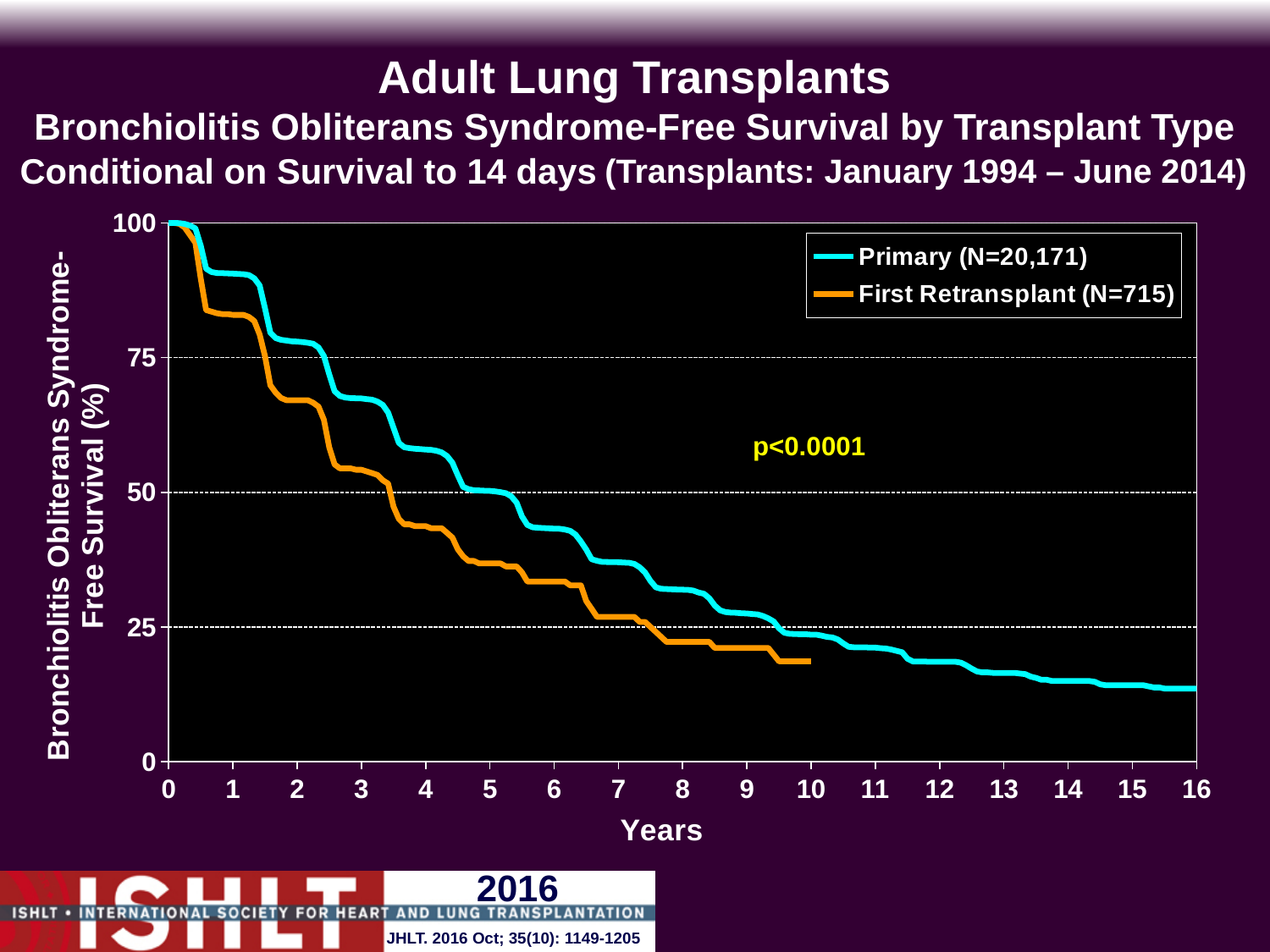
What p-value is printed on the chart? p<0.0001 What is the number of patients (N) in the First Retransplant group shown in the legend? 715 Is the BOS-free survival for the Primary group at 3 years greater or less than 50? greater How many series does the legend list? 2 Do the survival curves rise or fall as years increase along the x axis? fall What is the label of the x axis? Years Is the BOS-free survival for the Primary group at 16 years greater or less than 25? less Is the BOS-free survival for the First Retransplant group at 5 years greater or less than 50? less What is the number of patients (N) in the Primary group shown in the legend? 20,171 At 5 years, which group has the higher BOS-free survival, Primary or First Retransplant? Primary What kind of chart is shown on the slide? line chart